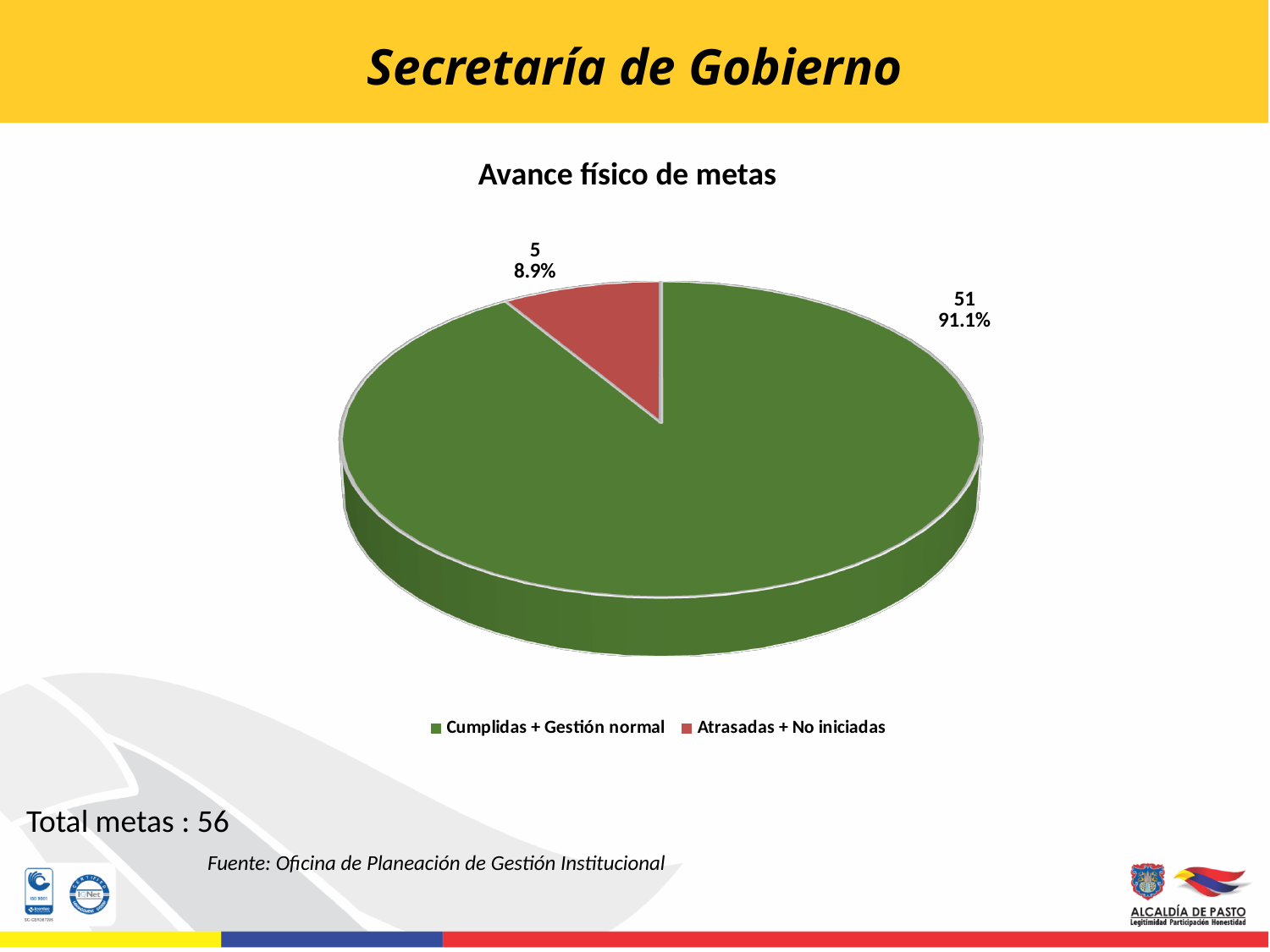
How many metas are in the 'Atrasadas + No iniciadas' slice? 5 What is the difference in number of metas between 'Cumplidas + Gestión normal' and 'Atrasadas + No iniciadas'? 46 What colour is the 'Atrasadas + No iniciadas' slice? Red What is the title of the chart? Avance físico de metas Which category has the largest slice? Cumplidas + Gestión normal What share of the pie does 'Atrasadas + No iniciadas' represent? 8.9% How many slices does the pie chart have? 2 How many metas are in the 'Cumplidas + Gestión normal' slice? 51 Which category has the smallest slice? Atrasadas + No iniciadas How many entries does the legend list? 2 What kind of chart is shown on the slide? Pie chart What share of the pie does 'Cumplidas + Gestión normal' represent? 91.1%